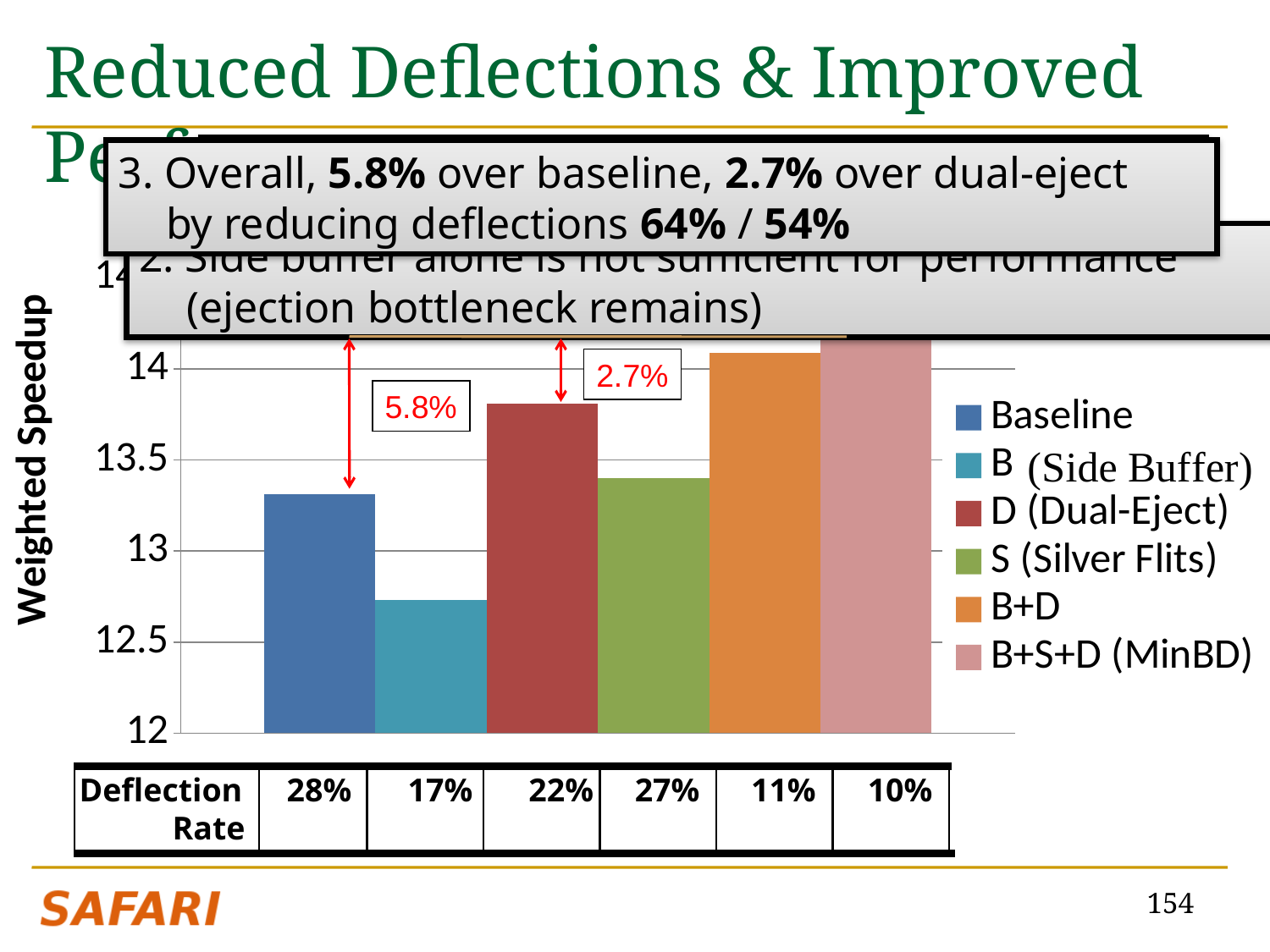
Is the weighted speedup for D (Dual-Eject) greater or less than 13.5? greater How many entries does the chart legend list? 6 Which configuration has the highest weighted speedup? B+S+D (MinBD) What kind of chart is shown on the slide? bar chart What percentage improvement is annotated between the Baseline bar and the B+S+D (MinBD) level? 5.8% Is the weighted speedup for B+D greater or less than 14? greater How many bars are plotted in the chart? 6 Which has a higher weighted speedup, D (Dual-Eject) or S (Silver Flits)? D (Dual-Eject) Which configuration has the lowest weighted speedup? B (Side Buffer) Is the weighted speedup for B (Side Buffer) greater or less than 13? less What is the label on the y axis of the chart? Weighted Speedup